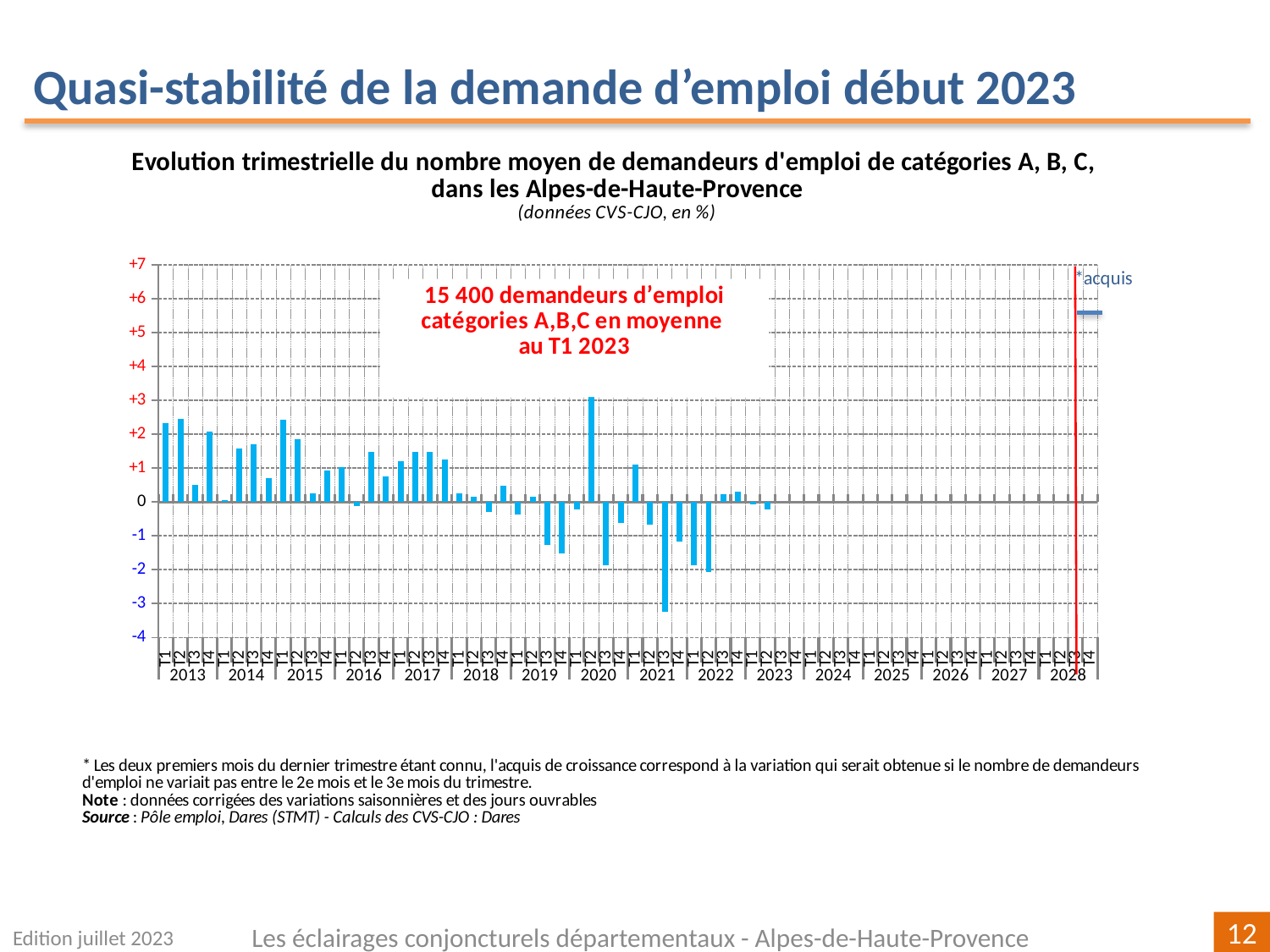
Which quarter has the highest value in the chart? T2 2020 How many years are labelled along the x axis of the chart? 16 Is the value for T3 2019 greater or less than -1? less Which is larger, the value for T1 2021 or the value for T3 2021? T1 2021 Is the value for T2 2020 greater or less than +2? greater Is the value for T3 2021 greater or less than -2? less According to the text box inside the chart, how many job seekers in categories A, B, C were there on average in T1 2023? 15 400 Which is larger, the value for T2 2020 or the value for T1 2013? T2 2020 Which quarter has the lowest value in the chart? T3 2021 What kind of chart is shown on the slide? bar chart